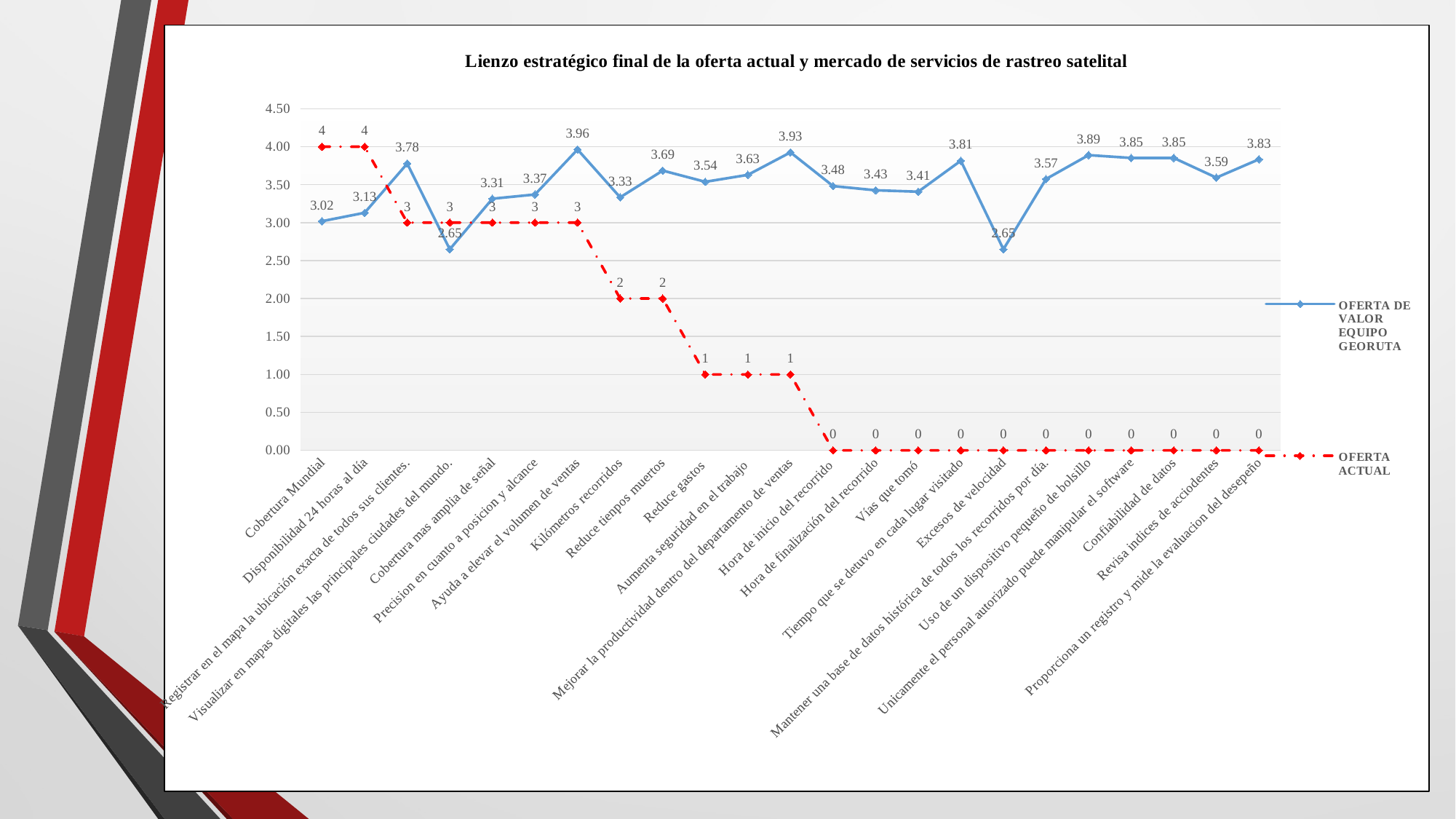
Which category has the highest value for the OFERTA DE VALOR EQUIPO GEORUTA series? Ayuda a elevar el volumen de ventas What is the title of the chart? Lienzo estratégico final de la oferta actual y mercado de servicios de rastreo satelital What type of chart is shown on the slide? Line chart What is the value of OFERTA DE VALOR EQUIPO GEORUTA for 'Ayuda a elevar el volumen de ventas'? 3.96 Does the OFERTA ACTUAL series generally rise or fall from left to right along the x axis? Fall How many categories are plotted along the x axis? 23 What is the difference between OFERTA DE VALOR EQUIPO GEORUTA and OFERTA ACTUAL for 'Reduce gastos'? 2.54 For 'Cobertura Mundial', which series has the larger value, OFERTA DE VALOR EQUIPO GEORUTA or OFERTA ACTUAL? OFERTA ACTUAL What is the value of OFERTA DE VALOR EQUIPO GEORUTA for 'Excesos de velocidad'? 2.65 How many series does the legend list? 2 What is the value of OFERTA ACTUAL for 'Kilómetros recorridos'? 2 What is the value of OFERTA ACTUAL for 'Confiabilidad de datos'? 0